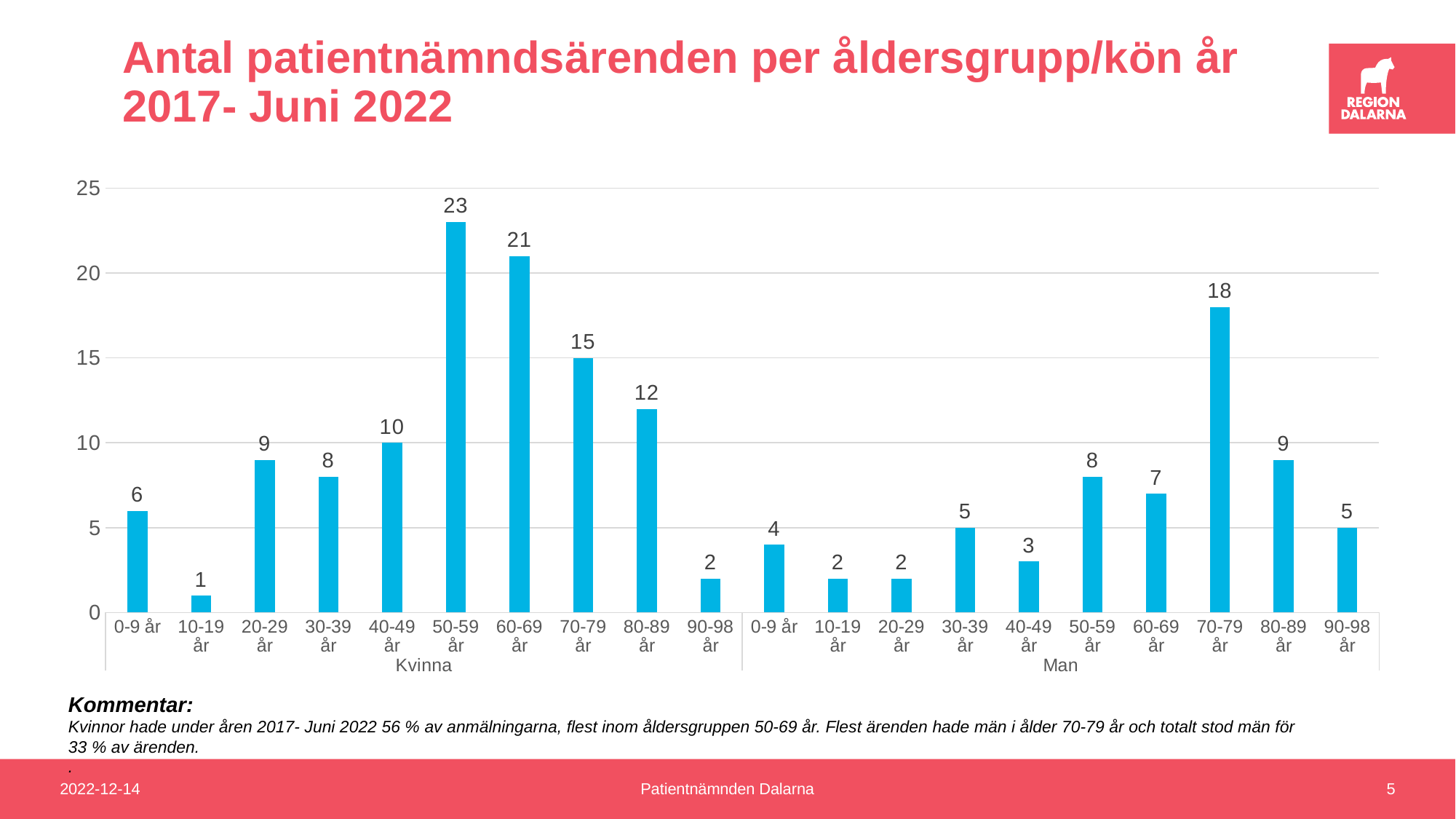
Which is larger: the 80-89 år value under Kvinna or the 80-89 år value under Man? Kvinna (12) What is the difference between the 50-59 år value under Kvinna and the 50-59 år value under Man? 15 How many age-group bars are shown in total across both Kvinna and Man? 20 What is the difference between the 60-69 år value under Kvinna and the 60-69 år value under Man? 14 What is the value for the 50-59 år age group under Kvinna? 23 What is the value for the 70-79 år age group under Man? 18 What is the value for the 10-19 år age group under Kvinna? 1 What is the value for the 40-49 år age group under Man? 3 What kind of chart is shown on the slide? Bar chart Which age group has the lowest value under Kvinna? 10-19 år Which age group has the highest value under Man? 70-79 år What are the two group labels shown along the x axis? Kvinna and Man